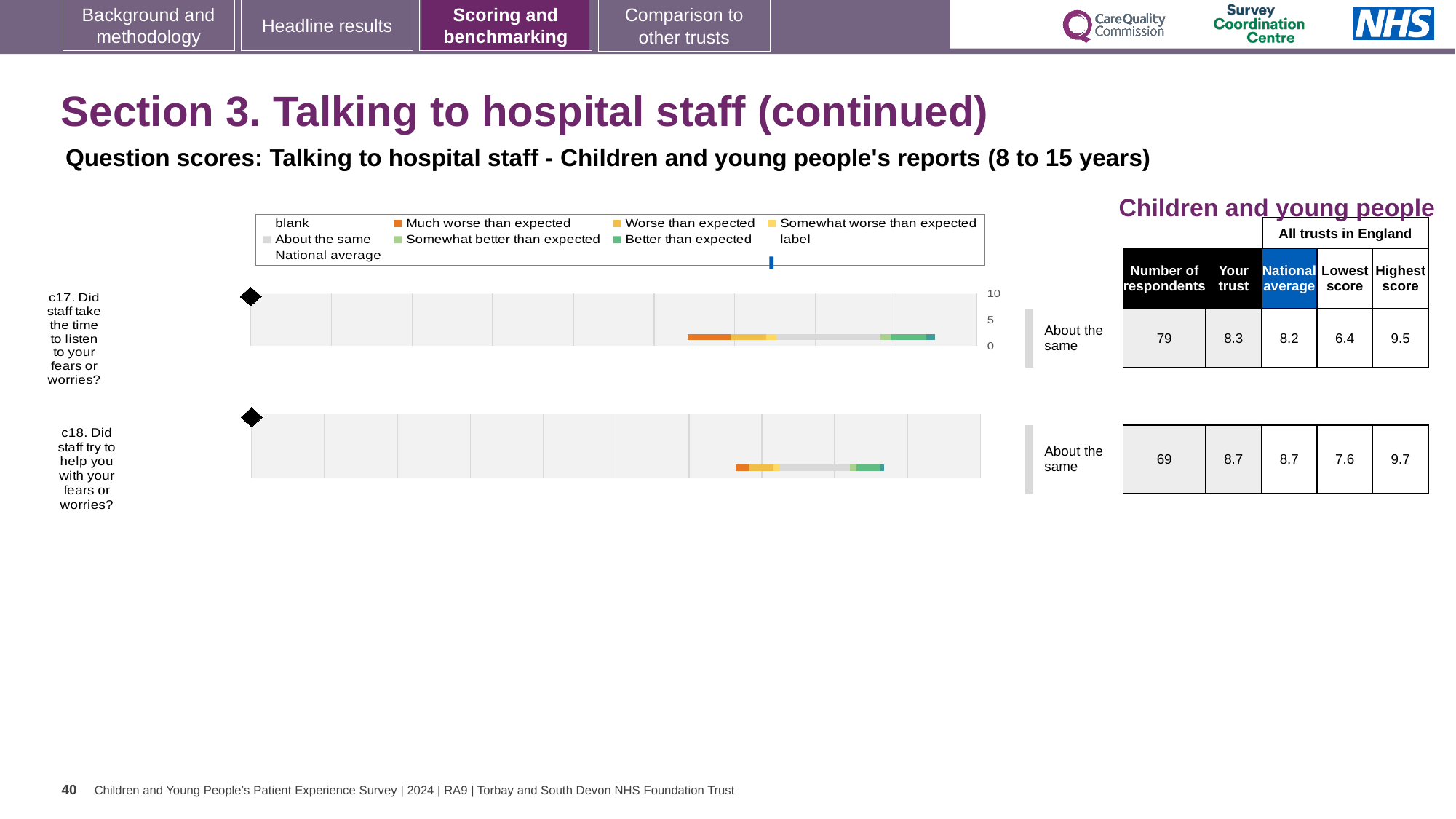
What is the highest score across all trusts in England for c18? 9.7 What benchmark category is shown next to the c17 chart? About the same What is the 'Your trust' score for c18 (Did staff try to help you with your fears or worries?)? 8.7 What kind of chart is used to show the question scores for c17 and c18? Bar chart How many respondents answered c18? 69 What colour does the legend use for 'Much worse than expected'? Orange What is the subtitle above the charts? Question scores: Talking to hospital staff - Children and young people's reports (8 to 15 years) What is the 'Your trust' score for c17 (Did staff take the time to listen to your fears or worries?)? 8.3 What is the difference between the highest score and the lowest score for c17? 3.1 What is the national average score for c17? 8.2 How many survey questions are plotted on the slide? 2 Which question has the higher 'Your trust' score, c17 or c18? c18